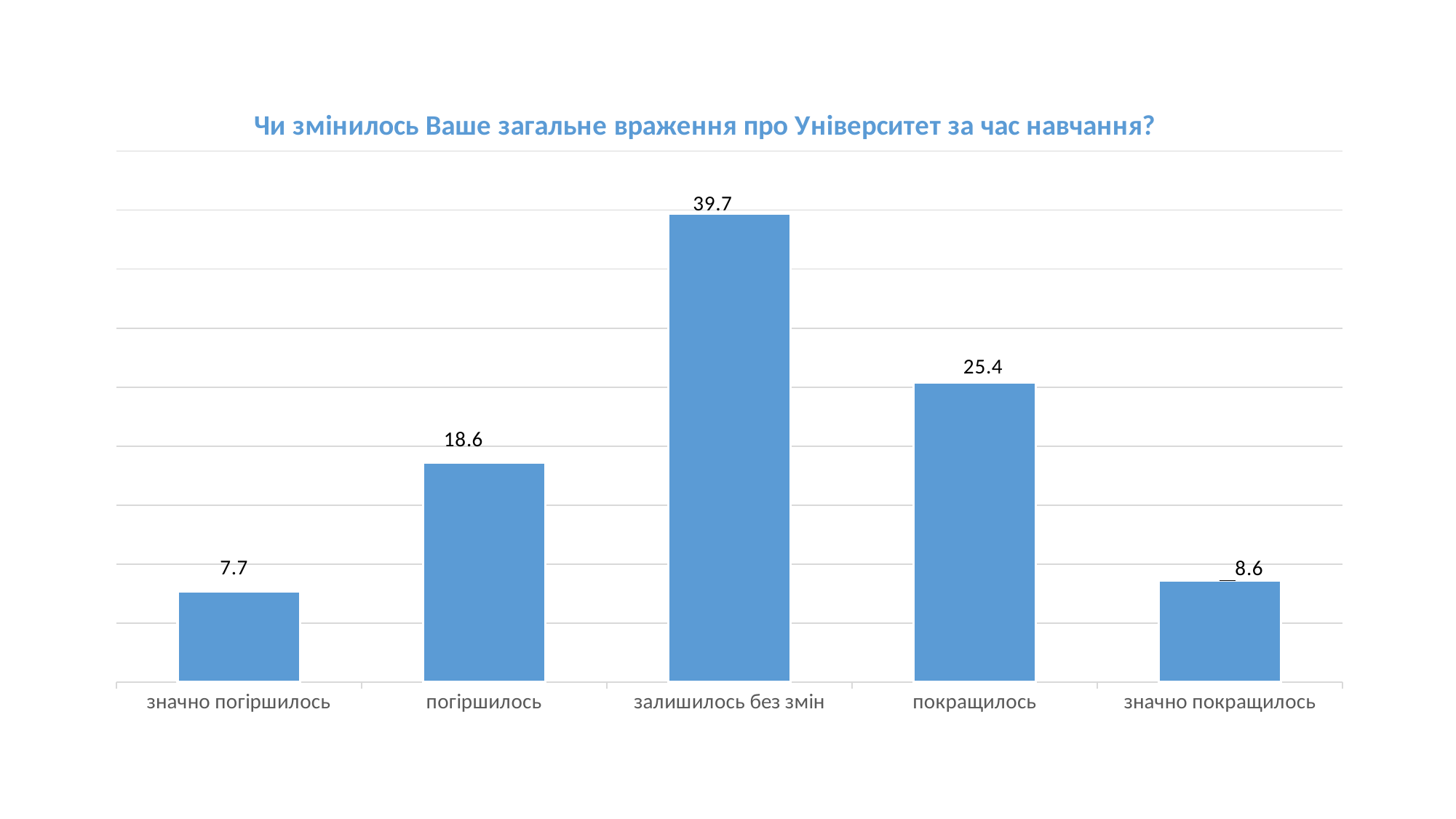
What is the value for "покращилось"? 25.4 What is the difference between the values for "залишилось без змін" and "покращилось"? 14.3 What is the title of the chart? Чи змінилось Ваше загальне враження про Університет за час навчання? Which is larger, the value for "покращилось" or the value for "погіршилось"? покращилось What is the value for "залишилось без змін"? 39.7 Which category has the highest value? залишилось без змін Which category has the lowest value? значно погіршилось What is the difference between the values for "погіршилось" and "значно погіршилось"? 10.9 What is the value for "значно покращилось"? 8.6 What type of chart is shown on the slide? bar chart What is the value for "значно погіршилось"? 7.7 How many categories are shown on the x axis? 5